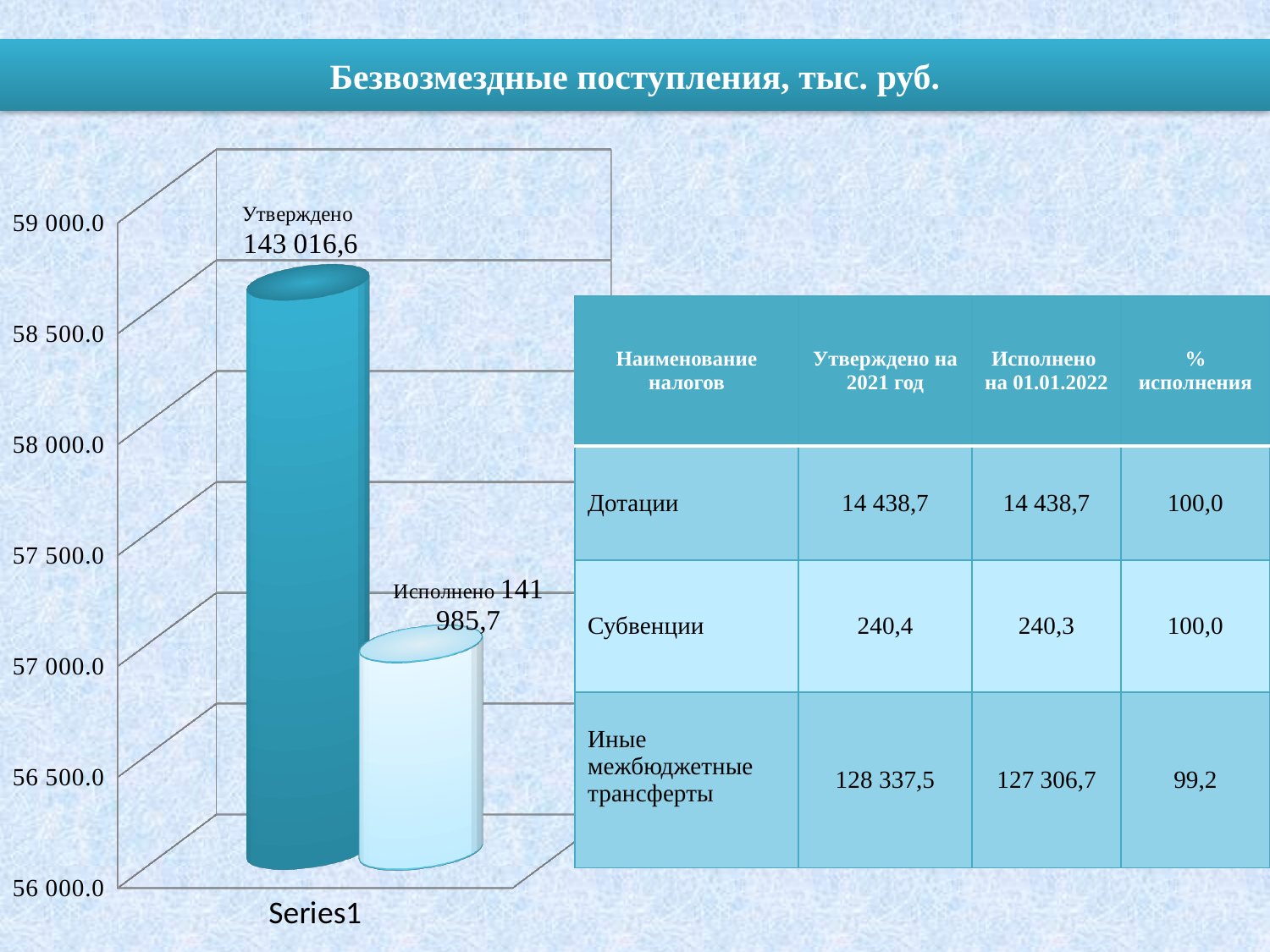
Which bar has the highest value? Утверждено Which bar has the lowest value? Исполнено What is the difference between the Утверждено and Исполнено values? 1 030,9 What is the value of the Утверждено bar? 143 016,6 What label appears under the bars on the horizontal axis? Series1 Which bar is taller, Утверждено or Исполнено? Утверждено What is the title of the slide? Безвозмездные поступления, тыс. руб. How many bars are plotted in the chart? 2 What is the value of the Исполнено bar? 141 985,7 What kind of chart is shown on the slide? Bar chart